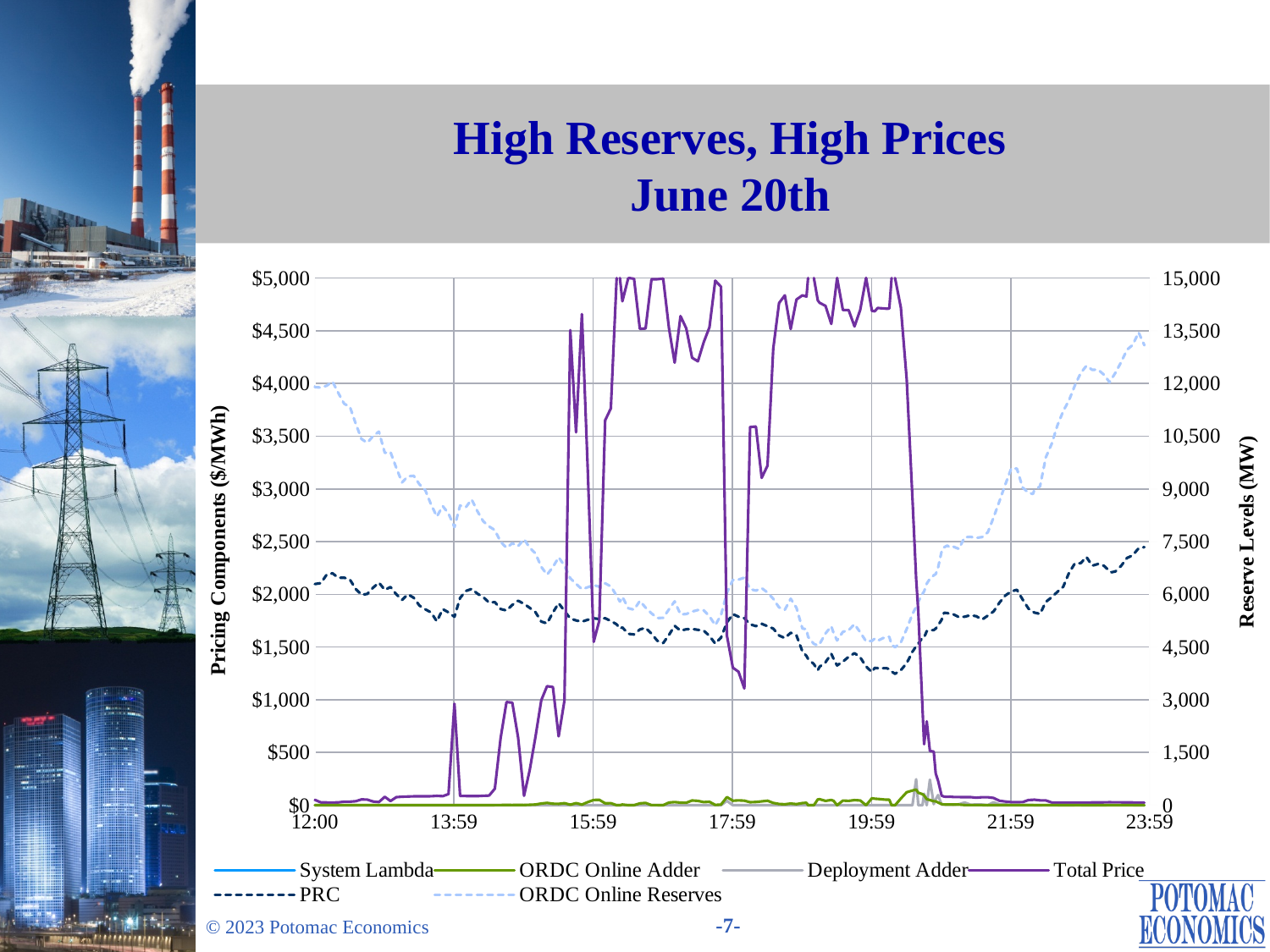
Is the value of ORDC Online Reserves at 13:59 greater or less than 6,000? greater Is the value of Total Price at 12:00 greater or less than $500? less Is the value of ORDC Online Reserves at 23:59 greater or less than 12,000? greater Does ORDC Online Reserves rise or fall between 19:59 and 23:59? Rise How many series does the legend list? 6 What is the title of the chart on the slide? High Reserves, High Prices June 20th Does ORDC Online Reserves rise or fall between 12:00 and 15:59? Fall What kind of chart is shown on the slide? Line chart What is the label of the right-hand vertical axis? Reserve Levels (MW)